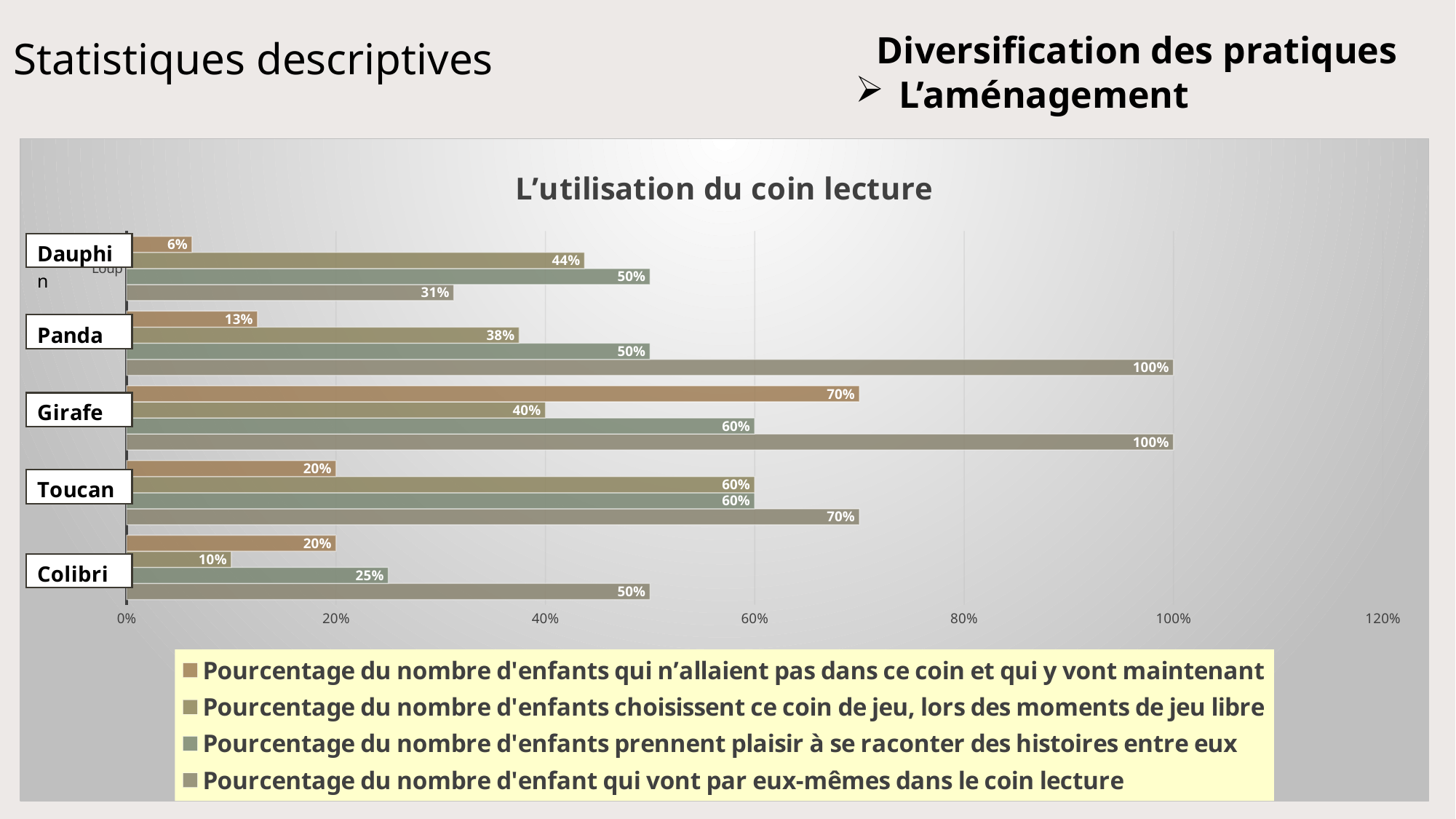
What is the value for Girafe in the series 'Pourcentage du nombre d'enfants qui n'allaient pas dans ce coin et qui y vont maintenant'? 70% What type of chart is shown on the slide? bar chart Which category has the lowest value in the series 'Pourcentage du nombre d'enfants qui n'allaient pas dans ce coin et qui y vont maintenant'? Dauphin How many series does the legend list? 4 How many categories (classes) are shown on the chart? 5 What is the difference between Toucan and Colibri in the series 'Pourcentage du nombre d'enfant qui vont par eux-mêmes dans le coin lecture'? 20% Which categories reach 100% in the series 'Pourcentage du nombre d'enfant qui vont par eux-mêmes dans le coin lecture'? Panda and Girafe Which category has the highest value in the series 'Pourcentage du nombre d'enfants choisissent ce coin de jeu, lors des moments de jeu libre'? Toucan What is the value for Colibri in the series 'Pourcentage du nombre d'enfants choisissent ce coin de jeu, lors des moments de jeu libre'? 10% What is the title of the chart? L'utilisation du coin lecture What is the value for Dauphin in the series 'Pourcentage du nombre d'enfant qui vont par eux-mêmes dans le coin lecture'? 31% In the series 'Pourcentage du nombre d'enfants prennent plaisir à se raconter des histoires entre eux', which is larger: Girafe or Colibri? Girafe